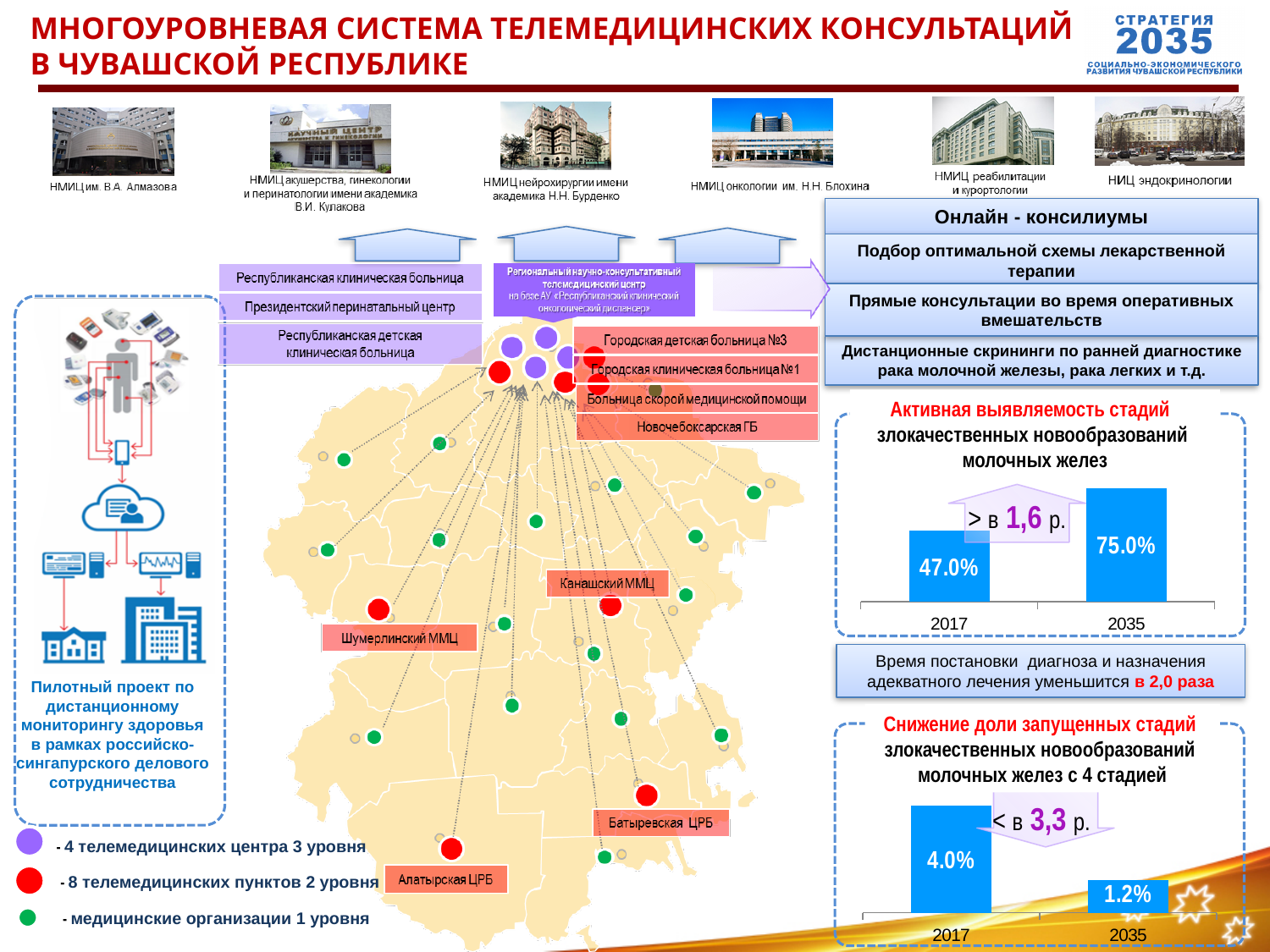
On the chart 'Снижение доли запущенных стадий злокачественных новообразований молочных желез с 4 стадией', what is the value for 2035? 1.2% On the chart 'Активная выявляемость стадий злокачественных новообразований молочных желез', what is the value for 2017? 47.0% On the chart 'Активная выявляемость стадий злокачественных новообразований молочных желез', what is the value for 2035? 75.0% On the chart 'Снижение доли запущенных стадий злокачественных новообразований молочных желез с 4 стадией', do the values rise or fall from 2017 to 2035? fall How many categories are shown on the x axis of the chart 'Активная выявляемость стадий злокачественных новообразований молочных желез'? 2 On the chart 'Активная выявляемость стадий злокачественных новообразований молочных желез', what is the difference between the 2035 and 2017 values? 28.0% On the chart 'Снижение доли запущенных стадий злокачественных новообразований молочных желез с 4 стадией', what is the difference between the 2017 and 2035 values? 2.8% On the chart 'Снижение доли запущенных стадий злокачественных новообразований молочных желез с 4 стадией', which year has the lower value? 2035 On the chart 'Снижение доли запущенных стадий злокачественных новообразований молочных желез с 4 стадией', is the value for 2017 larger or smaller than the value for 2035? larger On the chart 'Активная выявляемость стадий злокачественных новообразований молочных желез', which year has the higher value? 2035 On the chart 'Снижение доли запущенных стадий злокачественных новообразований молочных желез с 4 стадией', what is the value for 2017? 4.0% What kind of chart is 'Активная выявляемость стадий злокачественных новообразований молочных желез'? bar chart